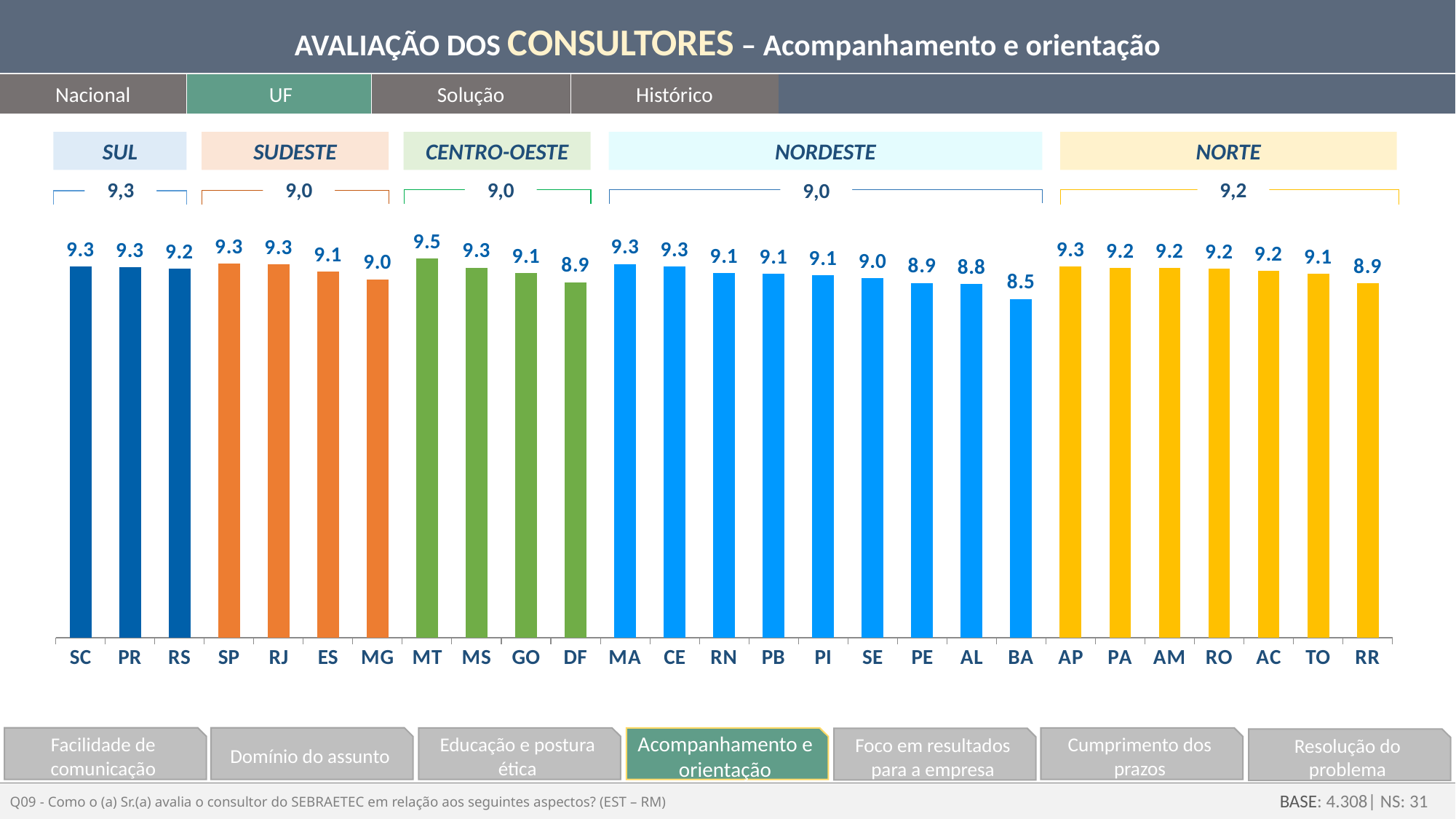
Which state has the lowest value? BA What is the value for BA? 8.5 What is the value for MT? 9.5 How many states are shown on the chart? 27 Which state has the highest value? MT What is the value for RR? 8.9 Which region's bars are coloured green? CENTRO-OESTE What is the difference between the values for SP and MG? 0.3 What kind of chart is shown? bar chart What is the regional average shown for NORTE? 9,2 Which is larger, the value for AL or the value for AP? AP What is the difference between the values for MT and BA? 1.0